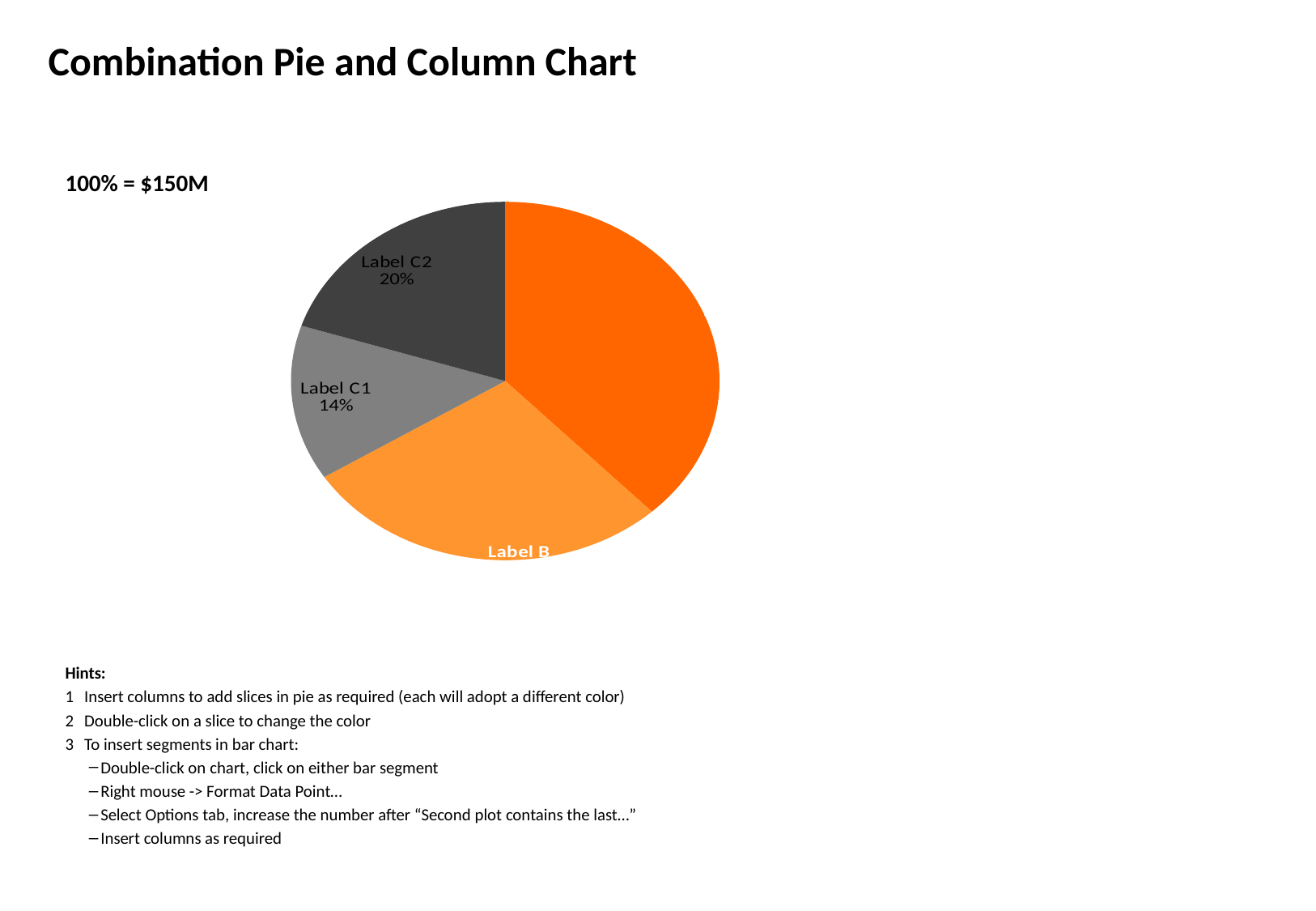
According to the text above the pie chart, what total amount does 100% represent? $150M What kind of chart is shown on the slide? pie chart Which slice is larger, Label B or Label C2? Label B How many slices does the pie chart have? 4 What is the difference in percentage points between the Label C2 slice and the Label C1 slice? 6% Which slice is larger, Label C1 or Label C2? Label C2 Which labeled slice is the smallest in the pie chart? Label C1 What percentage does the Label C1 slice represent in the pie chart? 14% What is the title of the slide containing the pie chart? Combination Pie and Column Chart What percentage does the Label C2 slice represent in the pie chart? 20% Which slice is larger, Label B or Label C1? Label B